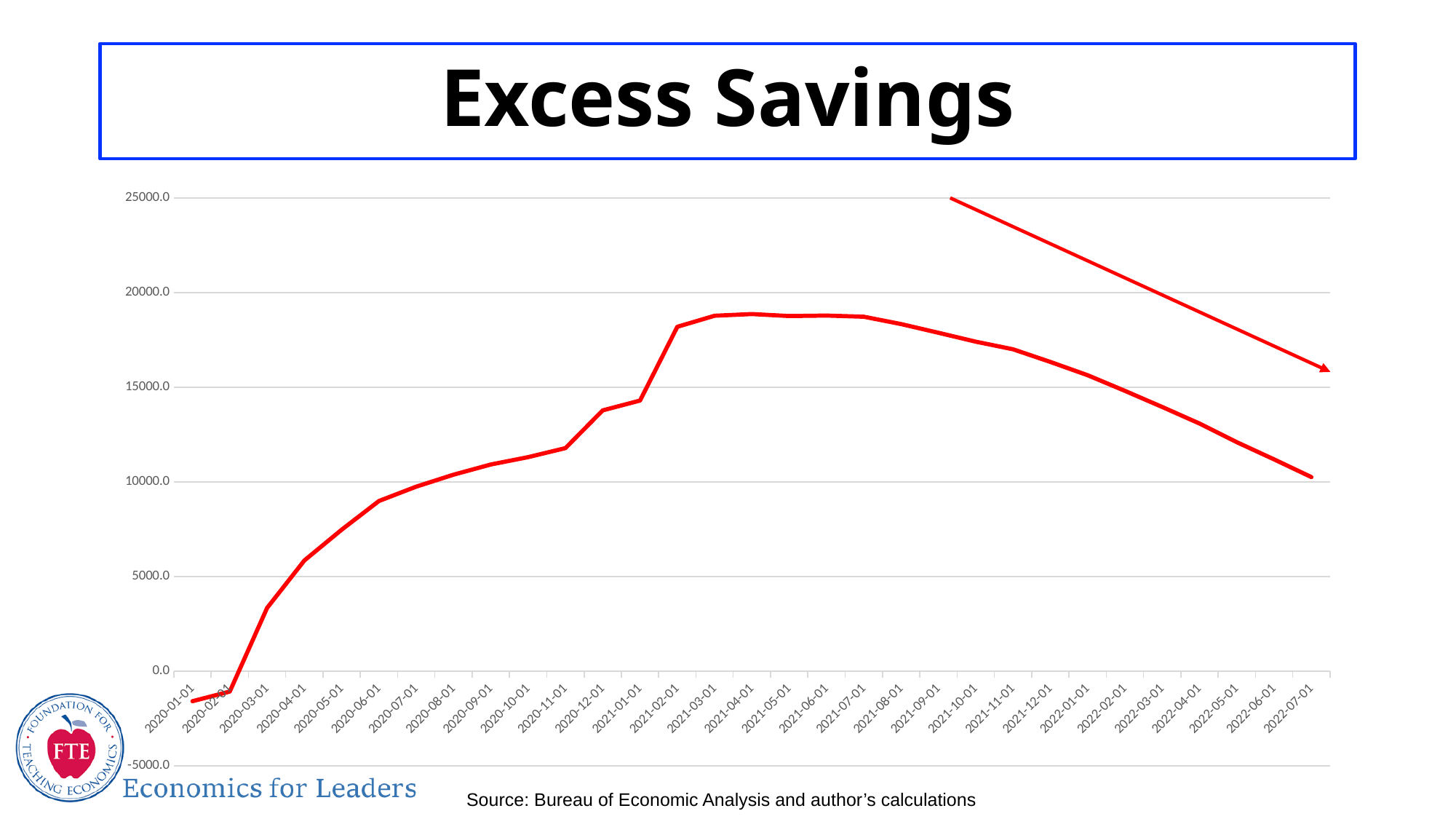
What is the title of the chart? Excess Savings Is the value for 2020-01-01 greater or less than 0.0? less What kind of chart is shown on the slide? line chart Which date has the lowest value on the chart? 2020-01-01 Is the value for 2020-06-01 greater or less than 10000.0? less Do the values rise or fall from 2020-01-01 to 2021-03-01? rise Is the value for 2021-04-01 greater or less than 20000.0? less How many monthly data points are plotted along the x axis? 31 Which is larger, the value for 2020-06-01 or the value for 2021-06-01? 2021-06-01 Do the values rise or fall from 2021-07-01 to 2022-07-01? fall